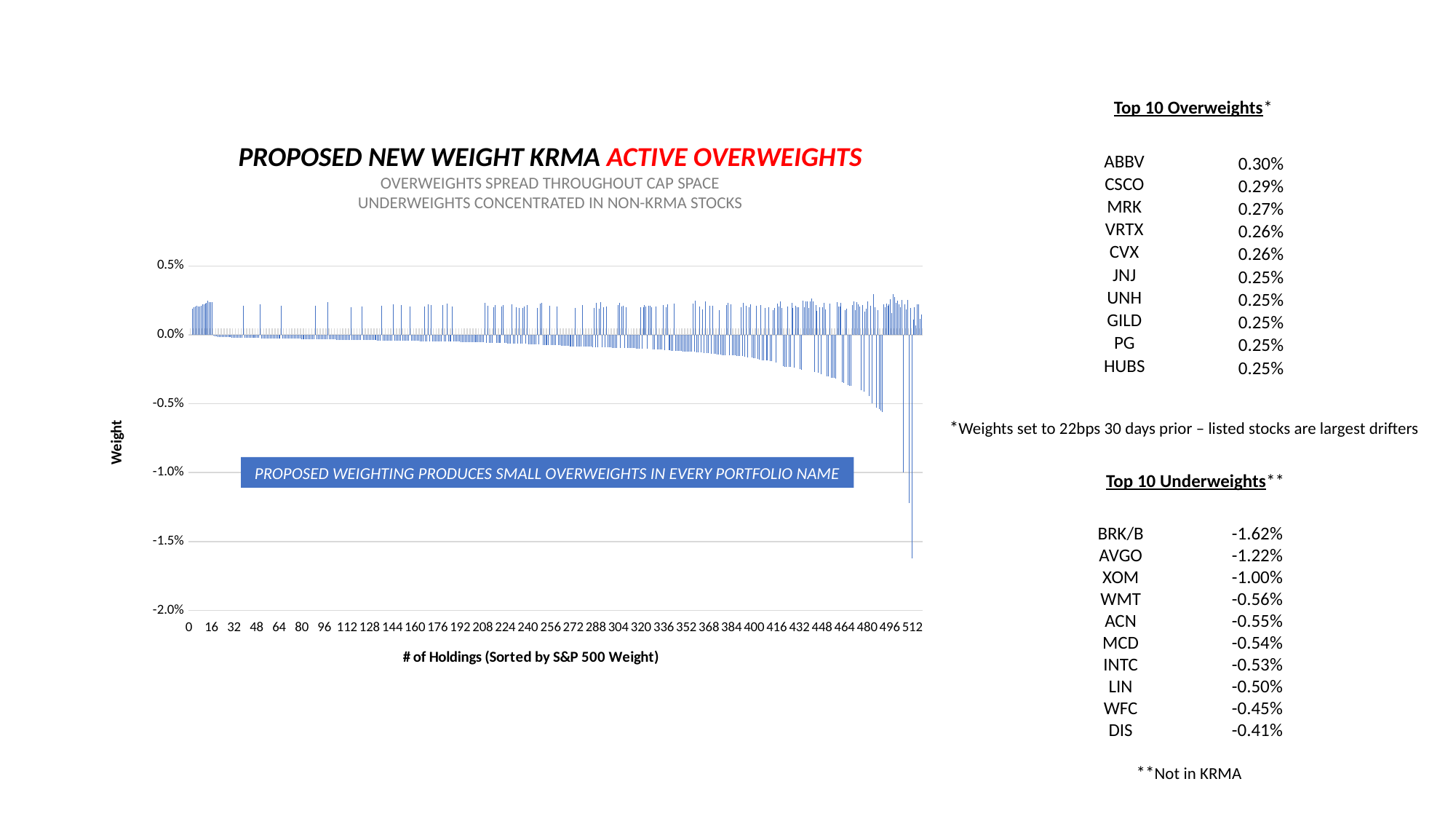
Do the negative bars in the chart generally become more negative or less negative moving from left to right along the x axis? more negative What is the title of the chart? PROPOSED NEW WEIGHT KRMA ACTIVE OVERWEIGHTS Is the tallest positive bar in the chart greater or less than 0.5%? less Is the most negative bar in the chart greater or less than -1.5%? less What is the label of the chart's x axis? # of Holdings (Sorted by S&P 500 Weight) Is the most negative bar in the chart greater or less than -1.0%? less What kind of chart is shown on the slide? bar chart